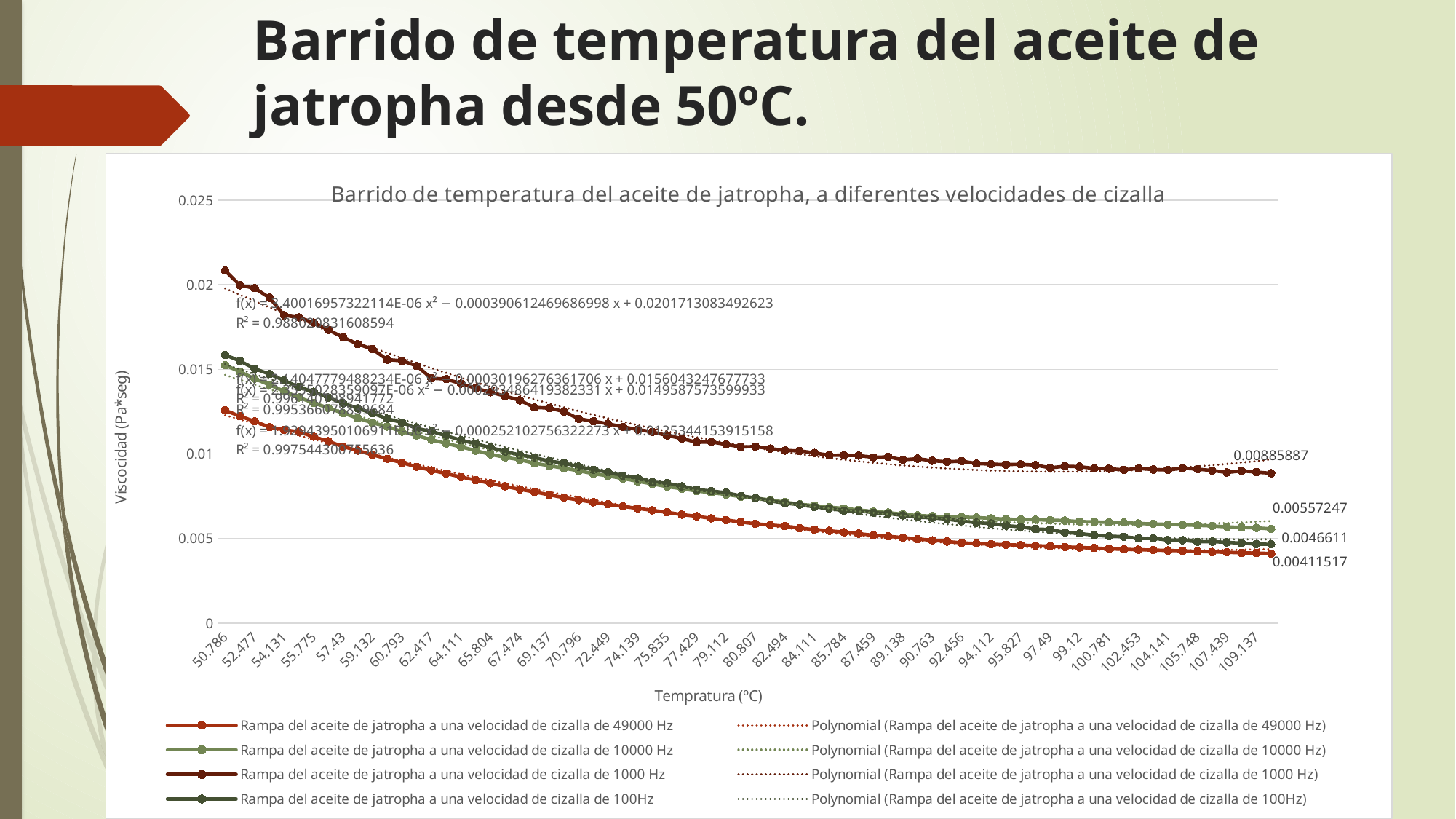
What is the title of the chart? Barrido de temperatura del aceite de jatropha, a diferentes velocidades de cizalla What is the final labelled viscosity value for the series at a shear rate of 49000 Hz? 0.00411517 Do the viscosity values rise or fall as temperature increases along the x axis? fall What kind of chart is shown on the slide? line chart What is the final labelled viscosity value for the series at a shear rate of 1000 Hz? 0.00885887 What is the difference between the final labelled values of the 1000 Hz series and the 49000 Hz series? 0.0047437 Which series has the lowest viscosity at the end of the temperature sweep? Rampa del aceite de jatropha a una velocidad de cizalla de 49000 Hz Which series has the highest viscosity at the end of the temperature sweep? Rampa del aceite de jatropha a una velocidad de cizalla de 1000 Hz What is the label of the vertical axis of the chart? Viscocidad (Pa*seg) What is the final labelled viscosity value for the series at a shear rate of 100Hz? 0.0046611 How many entries does the chart legend list? 8 What is the final labelled viscosity value for the series at a shear rate of 10000 Hz? 0.00557247